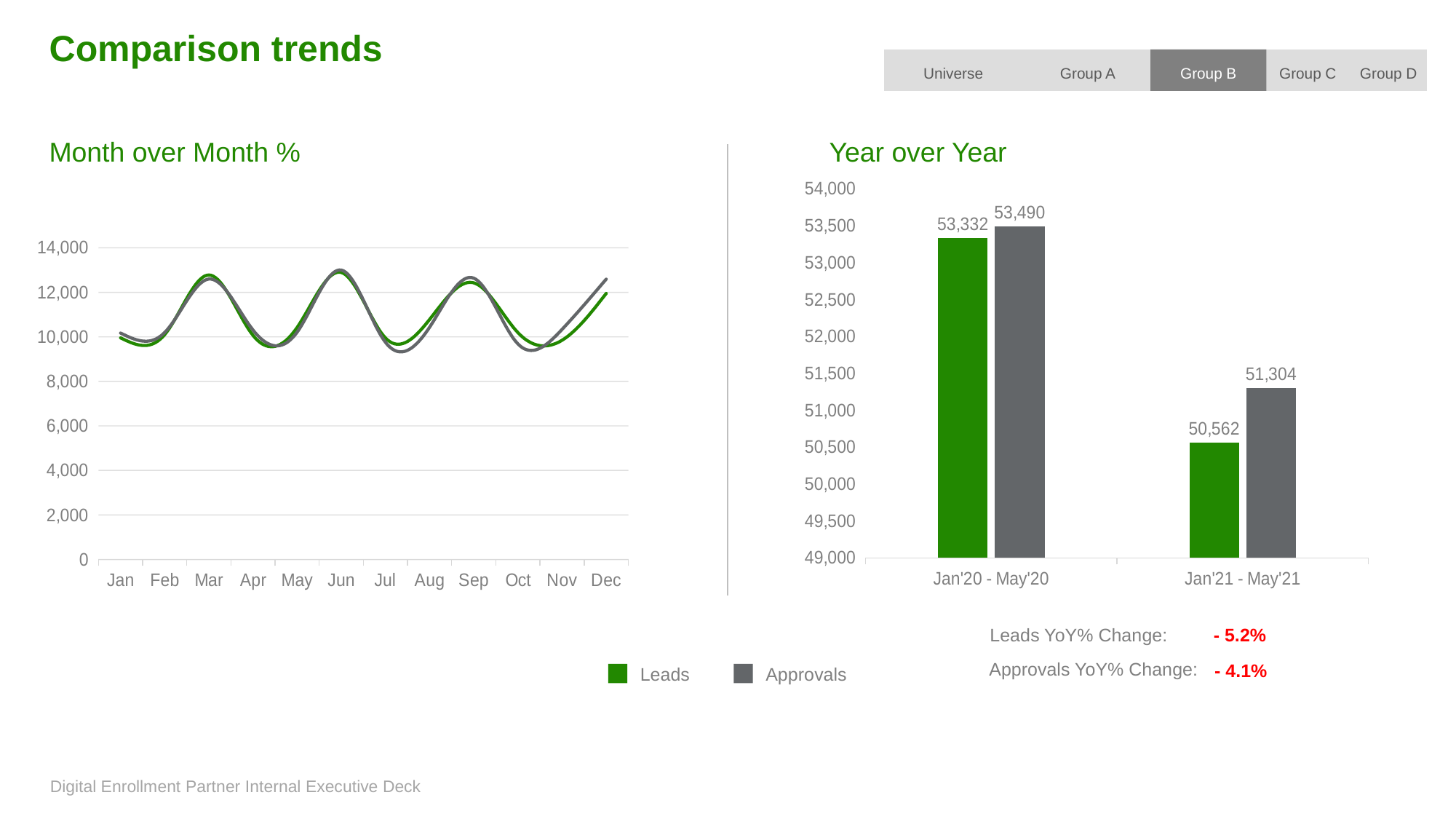
How many months are shown on the x axis of the Month over Month % chart? 12 In the Year over Year chart, what is the difference between Approvals and Leads for Jan'21 - May'21? 742 What kind of chart is the Month over Month % chart? Line chart In the Year over Year chart, what is the Leads value for Jan'20 - May'20? 53,332 In the Year over Year chart, what is the Leads value for Jan'21 - May'21? 50,562 In the Year over Year chart, which period has the lowest Leads value? Jan'21 - May'21 In the Year over Year chart, what is the Approvals value for Jan'21 - May'21? 51,304 In the Year over Year chart, by how much did Leads fall from Jan'20 - May'20 to Jan'21 - May'21? 2,770 How many series does the legend list? 2 What kind of chart is the Year over Year chart? Bar chart In the Month over Month % chart, is the Leads value for Mar greater or less than 12,000? greater In the Year over Year chart, which is larger for Jan'20 - May'20, Leads or Approvals? Approvals